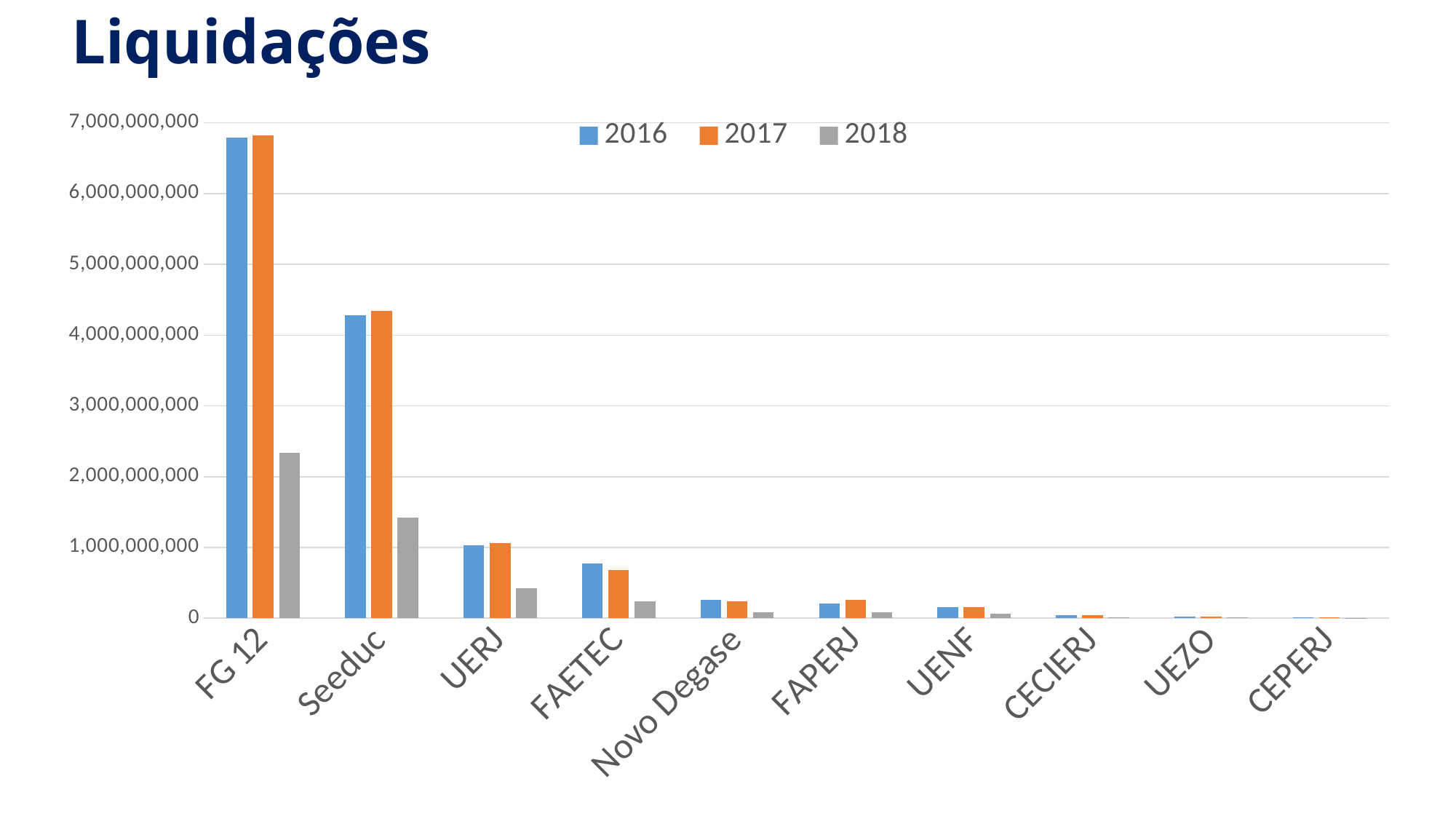
Is the value for FAETEC in 2016 greater or less than 1,000,000,000? less How many categories are shown on the x axis? 10 Is the value for Seeduc in 2017 greater or less than 4,000,000,000? greater Which category has the highest value for 2018? FG 12 Is the value for FG 12 in 2016 greater or less than 6,000,000,000? greater Do the values generally rise or fall moving from left to right along the x axis? fall Which category has the lowest values across all three years? CEPERJ How many series does the legend list? 3 Which is larger for 2018: FG 12 or Seeduc? FG 12 What is the title of the chart? Liquidações What kind of chart is shown on the slide? bar chart